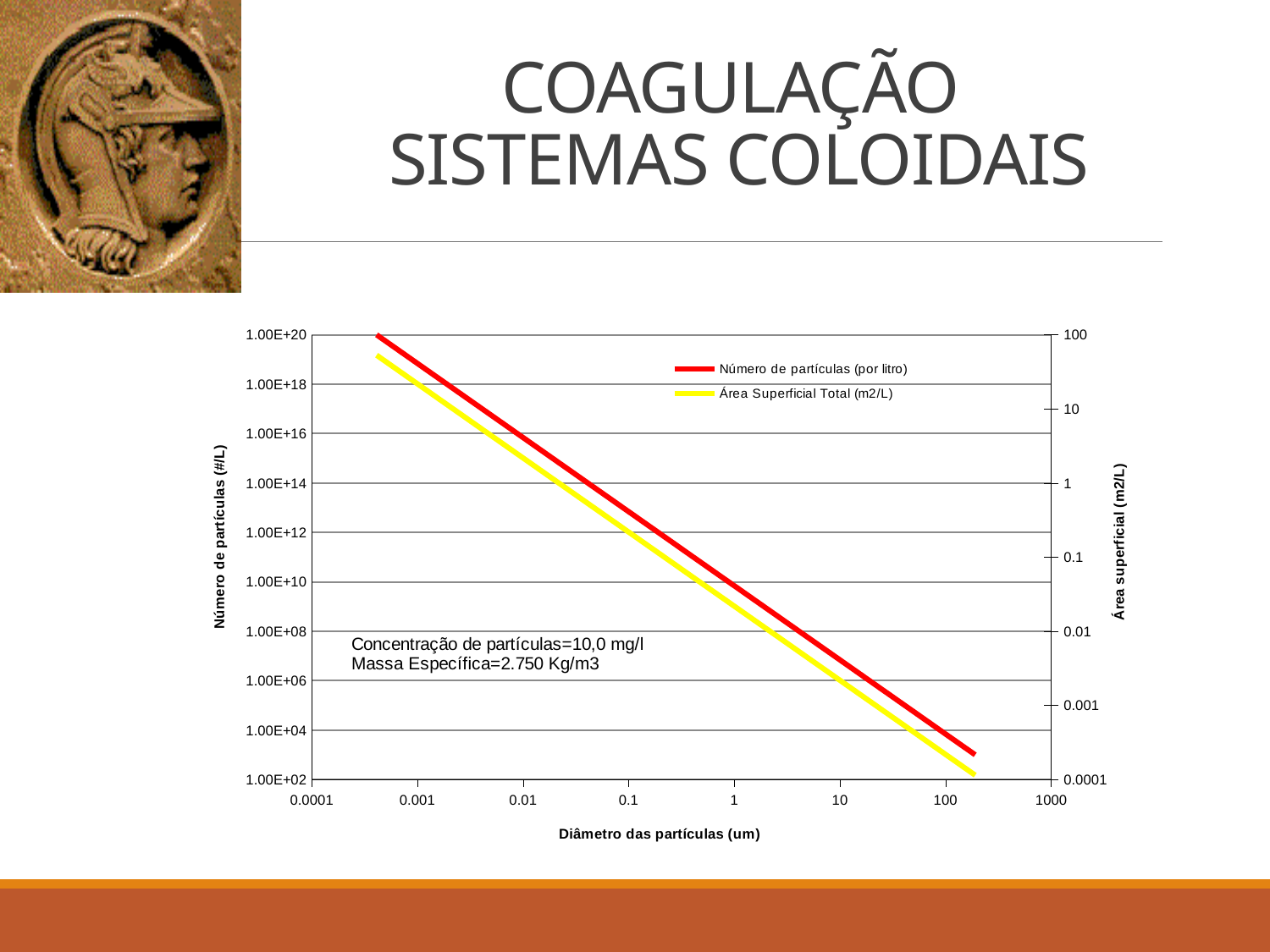
How many series does the chart legend list? 2 Do the values of Número de partículas (por litro) rise or fall as the particle diameter increases along the x axis? fall Do the values of Área Superficial Total (m2/L) rise or fall as the particle diameter increases along the x axis? fall Is the value of Área Superficial Total (m2/L) at a diameter of 1 um greater or less than 0.01? greater Which series is drawn in red? Número de partículas (por litro) What kind of chart is shown on the slide? line chart Is the value of Número de partículas (por litro) at a diameter of 0.001 um greater or less than 1.00E+16? greater What is the title of the x axis? Diâmetro das partículas (um) Is the value of Número de partículas (por litro) at a diameter of 100 um greater or less than 1.00E+06? less